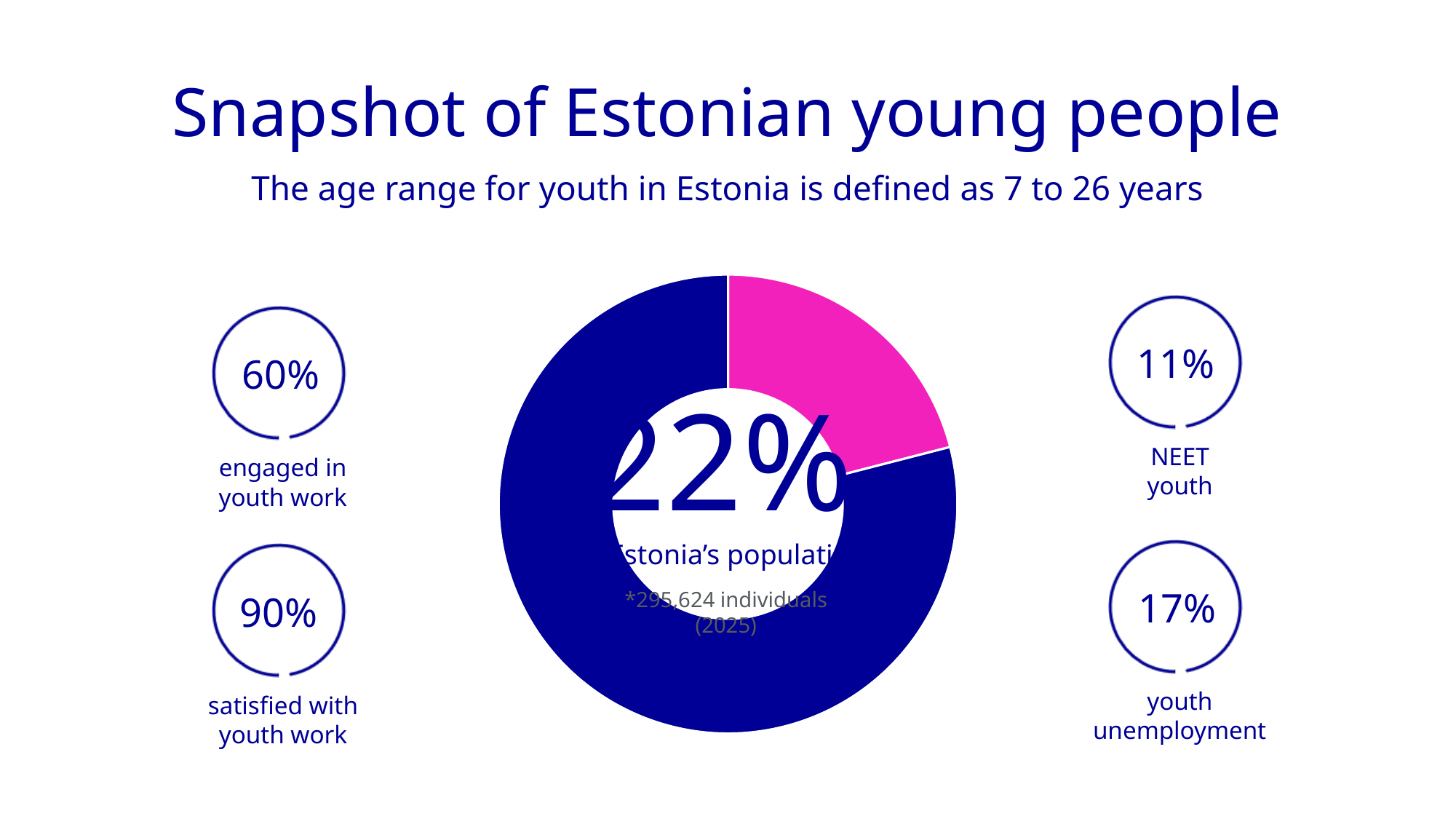
How many slices does the donut chart have? 2 What does the 22% in the centre of the donut chart refer to? Estonia's population Is the share shown by the pink slice of the donut chart greater or less than 25%? less How many individuals does the 22% in the donut chart correspond to? 295,624 What year is given for the 295,624 individuals figure in the donut chart? 2025 What kind of chart is shown in the centre of the slide? pie chart (donut) What colour is the slice representing 22% in the donut chart? pink Which slice of the donut chart is larger, the pink one or the dark blue one? dark blue What share of Estonia's population does the pink slice of the donut chart represent? 22%